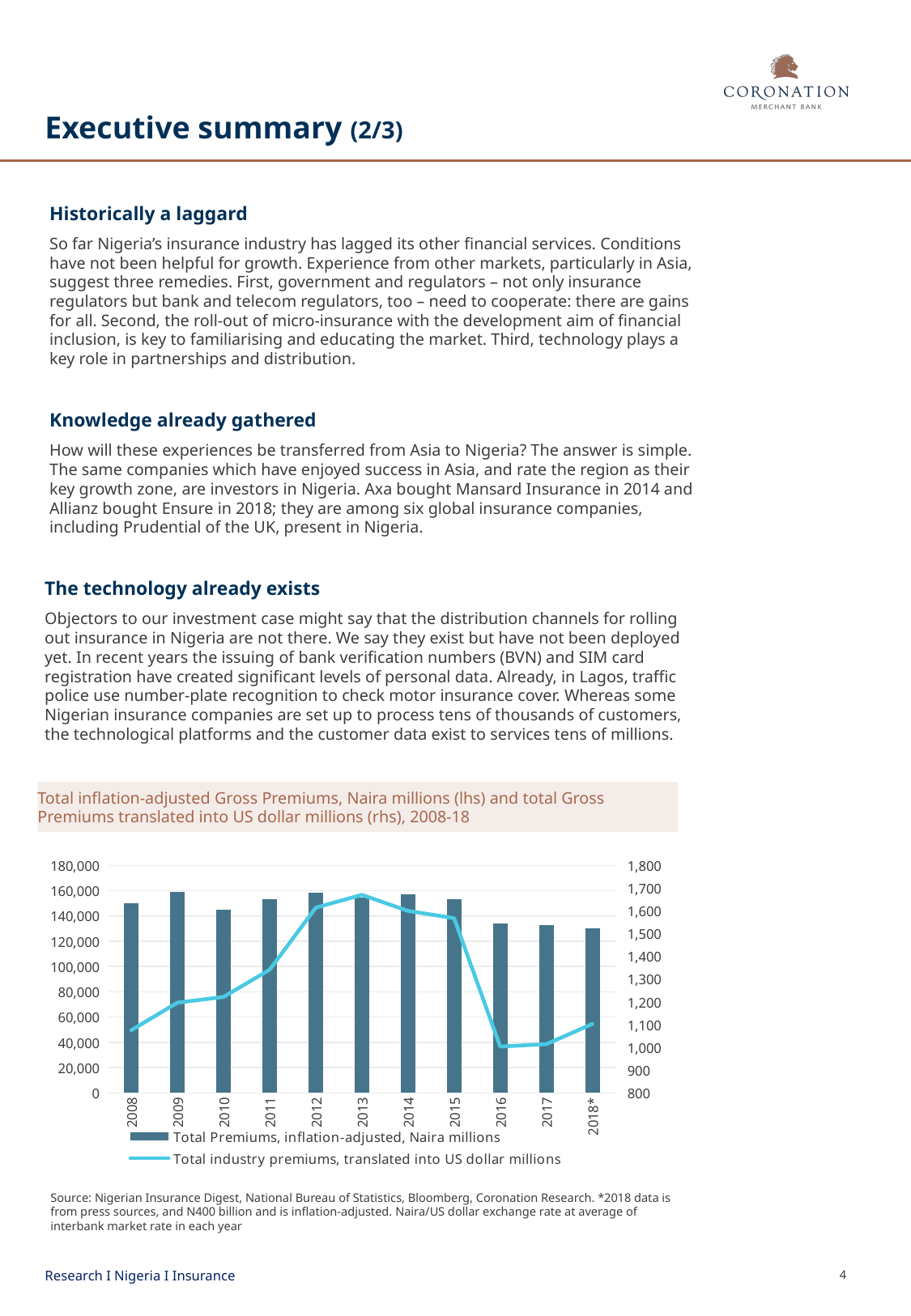
Is the inflation-adjusted Naira premiums bar for 2009 greater or less than 140,000? greater How many years are plotted along the x axis of the chart? 11 Is the US dollar premiums value for 2016 greater or less than 1,200? less Does the US dollar premiums line rise or fall between 2015 and 2016? fall How many series does the chart's legend list? 2 Which is larger, the inflation-adjusted Naira premiums bar for 2009 or for 2010? 2009 Which year has the highest value on the US dollar premiums line? 2013 Is the US dollar premiums value for 2013 greater or less than 1,500? greater Which series is drawn as bars in the chart? Total Premiums, inflation-adjusted, Naira millions What kind of chart is shown on the slide? A combined bar and line chart Which series is drawn as a line in the chart? Total industry premiums, translated into US dollar millions